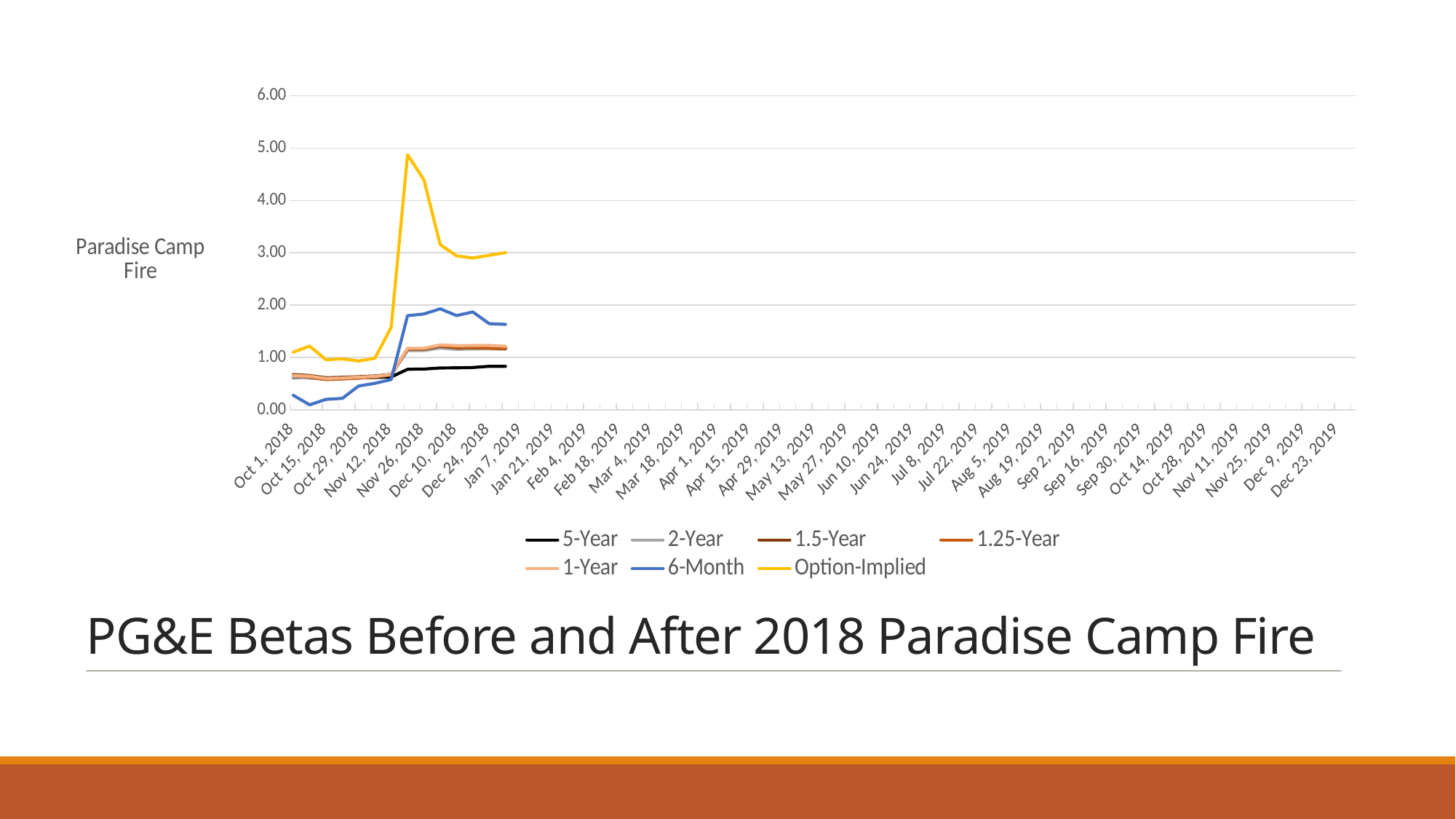
What kind of chart is shown on the slide? line chart How many series does the legend list? 7 What is the title of the slide? PG&E Betas Before and After 2018 Paradise Camp Fire At Oct 1, 2018, which is larger: the 5-Year series or the 6-Month series? 5-Year Is the peak value of the Option-Implied series greater or less than 4.00? greater Is the value of the 5-Year series at Jan 7, 2019 greater or less than 1.00? less Which series has the lowest value at Oct 15, 2018? 6-Month At Jan 7, 2019, which is larger: the Option-Implied series or the 5-Year series? Option-Implied Is the value of the 6-Month series at Jan 7, 2019 greater or less than 2.00? less Which series reaches the highest value on the chart? Option-Implied Does the 5-Year series rise or fall from Oct 1, 2018 to Jan 7, 2019? rise